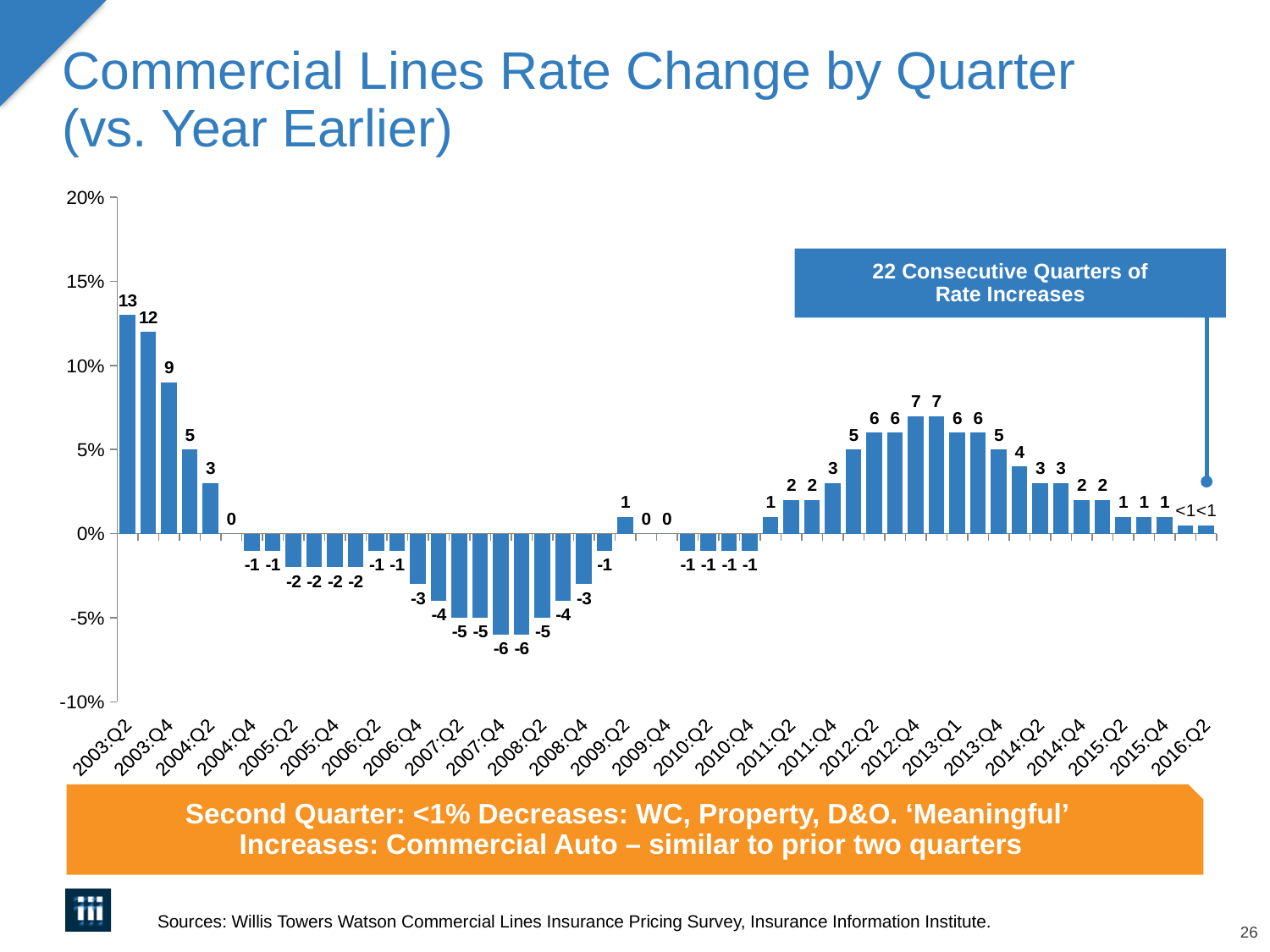
What kind of chart is shown on the slide? bar chart What is the rate change value for 2003:Q2, the first bar on the chart? 13 What does the blue callout box on the chart say? 22 Consecutive Quarters of Rate Increases What is the difference between the first two bars on the chart (13 and 12)? 1 Do the values rise or fall across the first six bars of the chart, from 2003:Q2 onward? fall What is the highest value labeled on the y axis? 20% What is the highest value shown on the chart? 13 What is the value labeled on the last bar, for 2016:Q2? <1 Is the value for 2003:Q2 greater or less than 10%? greater What is the rate change value for 2003:Q4? 9 Which has the larger value, the first bar (2003:Q2) or the second bar (2003:Q3)? 2003:Q2 What is the lowest value shown on the chart? -6